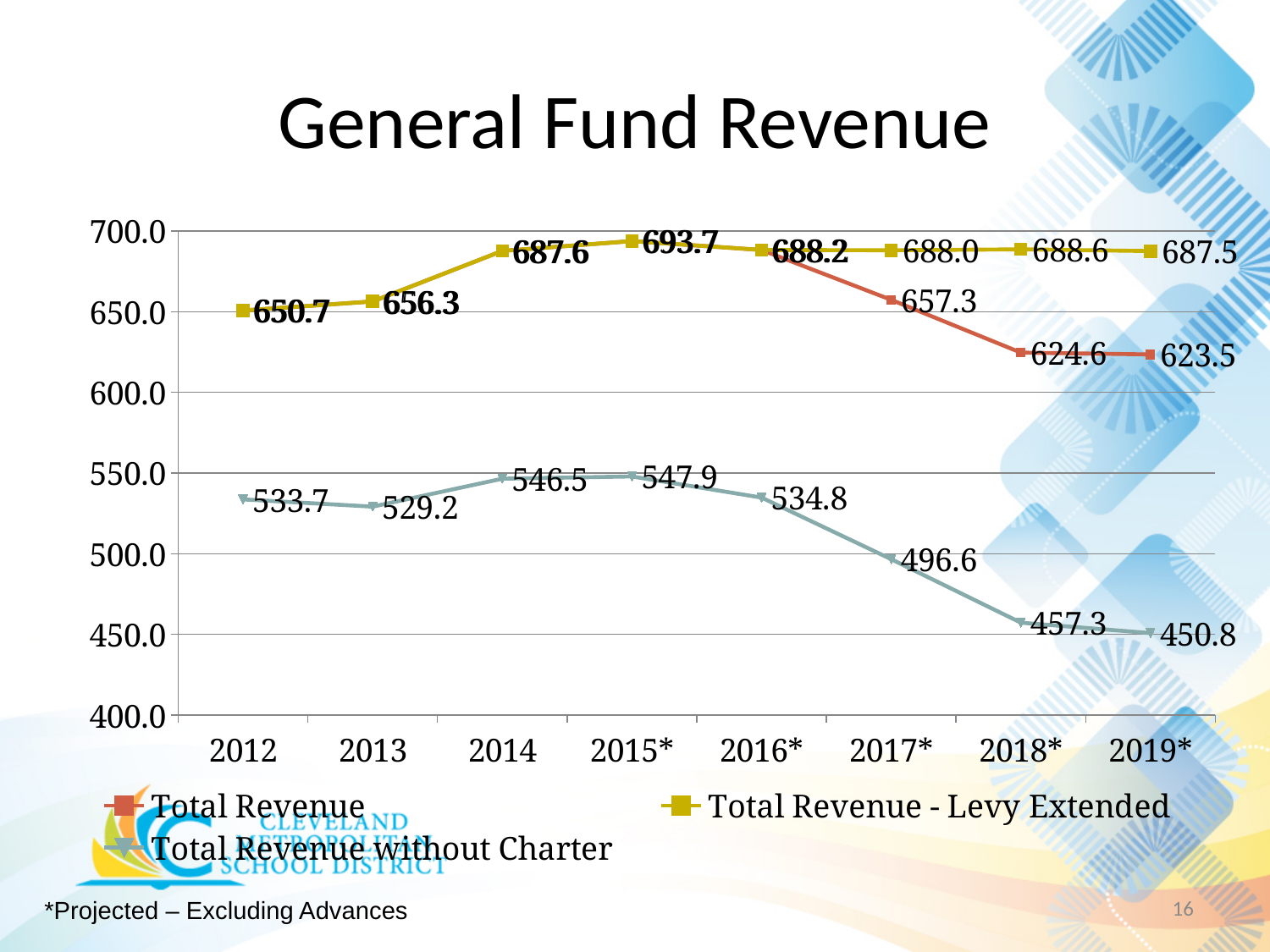
How many years are shown on the x axis? 8 How many series does the legend list? 3 In which year is Total Revenue without Charter highest? 2015* What is the difference between Total Revenue - Levy Extended and Total Revenue in 2019*? 64.0 In which year is Total Revenue without Charter lowest? 2019* Does Total Revenue without Charter rise or fall from 2016* to 2019*? fall What kind of chart is shown on the slide? line chart What is the value of Total Revenue - Levy Extended in 2019*? 687.5 What is the value of Total Revenue without Charter in 2018*? 457.3 What is the title of the chart? General Fund Revenue What is the value of Total Revenue in 2017*? 657.3 Which is larger in 2018*: Total Revenue or Total Revenue - Levy Extended? Total Revenue - Levy Extended